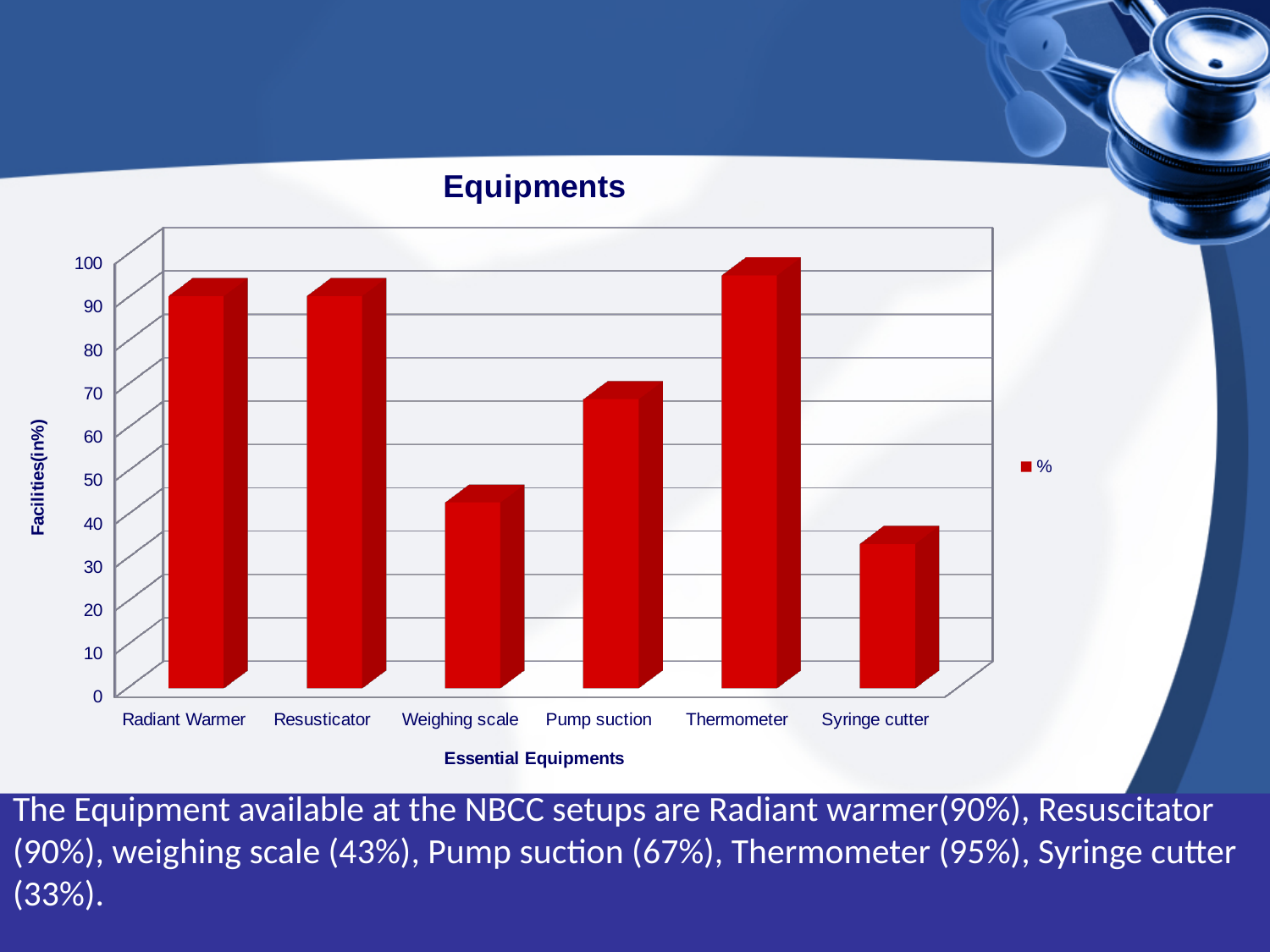
What is the label of the vertical axis? Facilities(in%) Which is larger, the value for Pump suction or the value for Weighing scale? Pump suction How many series does the chart legend list? 1 What is the value for Thermometer? 95% What type of chart is shown on the slide? Bar chart What is the value for Weighing scale? 43% What is the title of the chart? Equipments Which equipment has the lowest value in the chart? Syringe cutter How many equipment categories are plotted in the chart? 6 Is the value for Weighing scale greater or less than 50? less Which equipment has the highest value in the chart? Thermometer What is the difference between the values for Thermometer and Syringe cutter? 62 percentage points